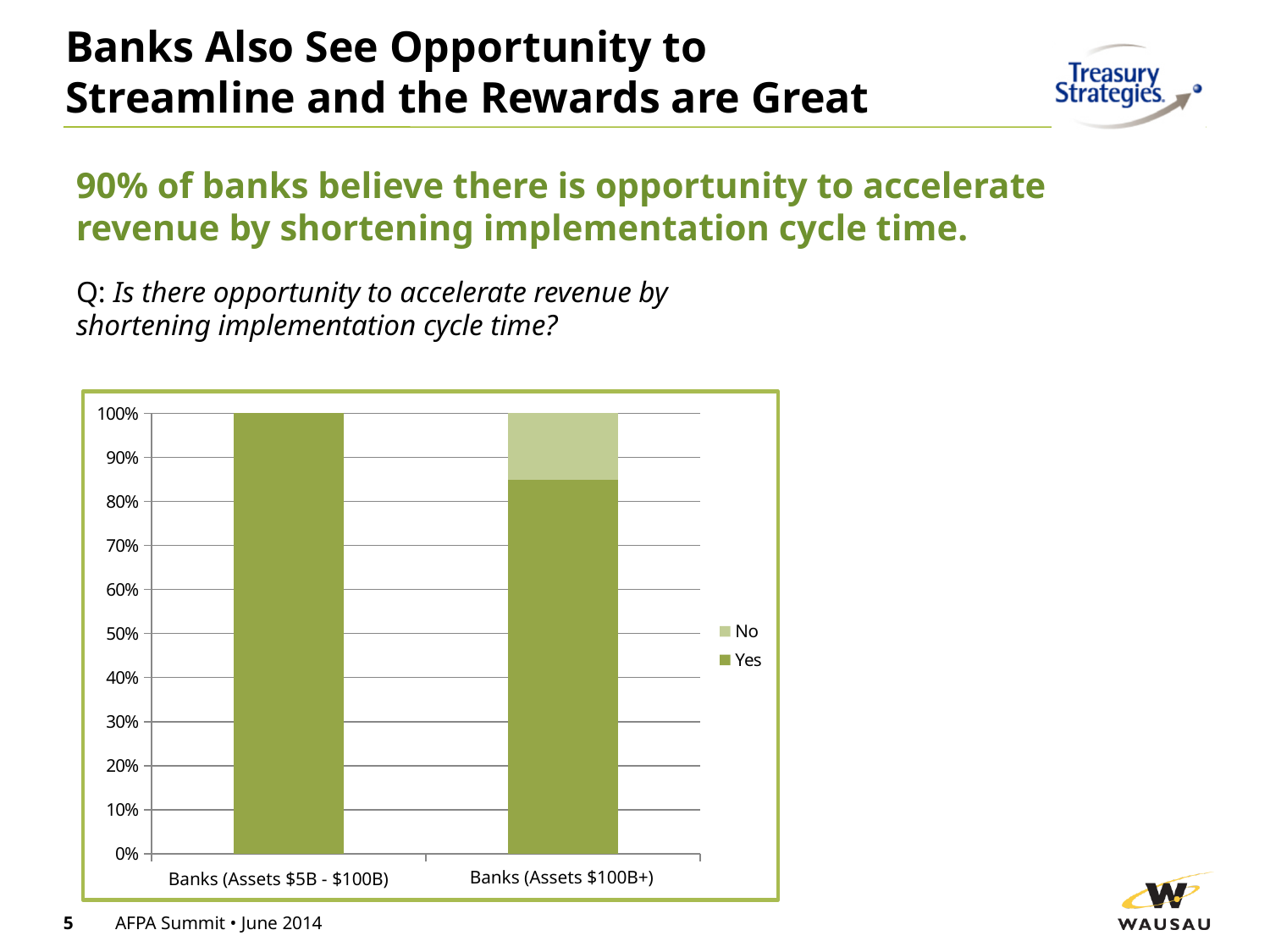
Which bank category has the lower 'Yes' share? Banks (Assets $100B+) What is the 'Yes' value for Banks (Assets $5B - $100B)? 100% Which series is shown in the darker green colour? Yes Which bank category has the higher 'Yes' share? Banks (Assets $5B - $100B) How many bank categories are shown on the x axis? 2 What are the two series named in the legend? No and Yes Is the 'No' value for Banks (Assets $100B+) greater or less than 20%? less Which bank category shows any 'No' responses? Banks (Assets $100B+) Is the 'Yes' value for Banks (Assets $100B+) greater or less than 80%? greater Is the 'Yes' value for Banks (Assets $100B+) greater or less than 90%? less How many series does the legend list? 2 What kind of chart is shown on the slide? Stacked bar chart